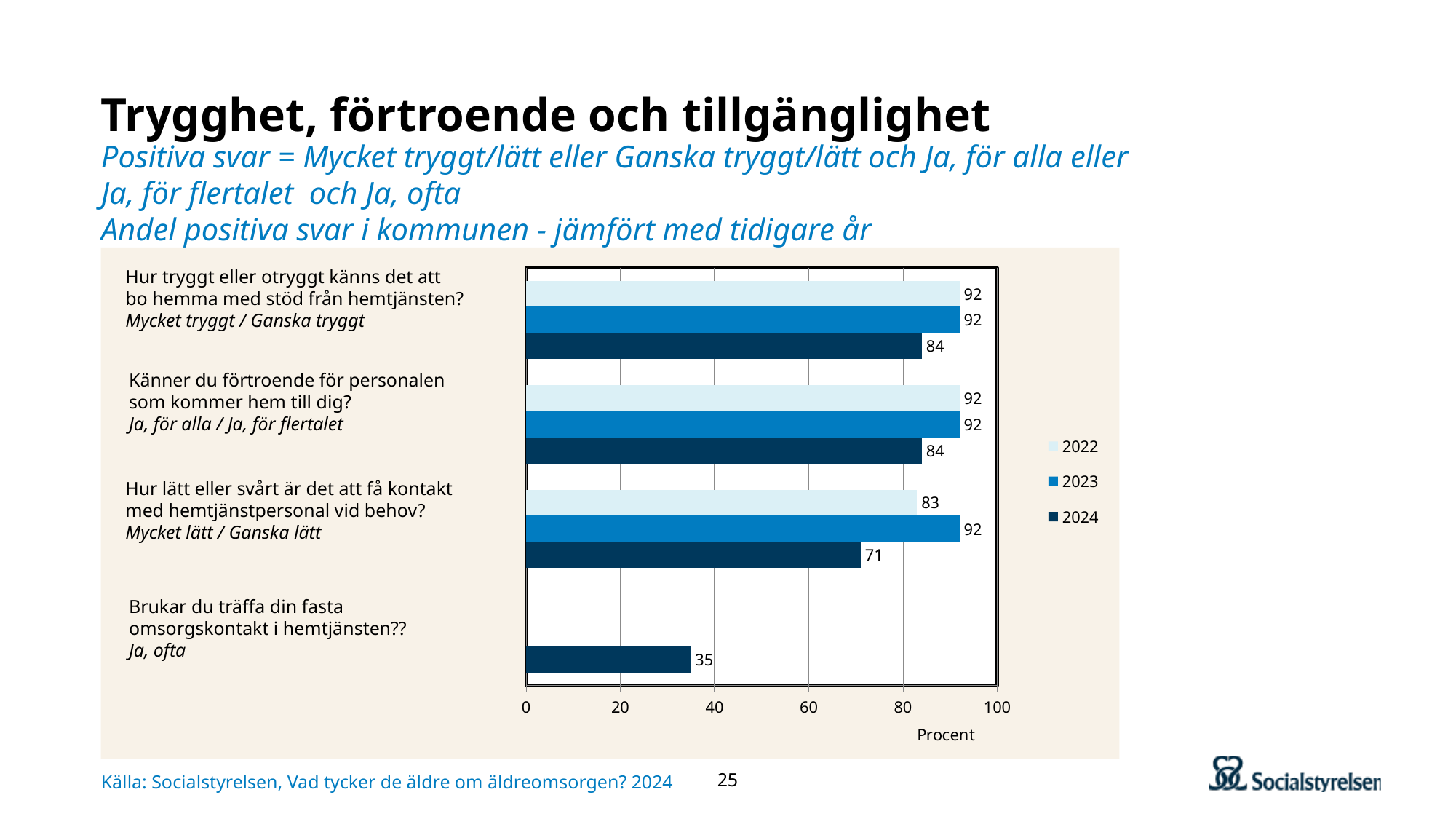
What is the difference between the 2023 and 2024 values for 'Hur lätt eller svårt är det att få kontakt med hemtjänstpersonal vid behov?'? 21 What is the 2024 value for 'Hur tryggt eller otryggt känns det att bo hemma med stöd från hemtjänsten?'? 84 How many series does the legend list? 3 Is the 2024 value for 'Känner du förtroende för personalen som kommer hem till dig?' larger or smaller than the 2023 value? smaller Which question has the lowest 2024 value? Brukar du träffa din fasta omsorgskontakt i hemtjänsten? Which years are listed in the legend? 2022, 2023, 2024 Is the 2024 value for 'Brukar du träffa din fasta omsorgskontakt i hemtjänsten?' greater or less than 40? less What is the 2023 value for 'Hur lätt eller svårt är det att få kontakt med hemtjänstpersonal vid behov?'? 92 What is the 2022 value for 'Hur lätt eller svårt är det att få kontakt med hemtjänstpersonal vid behov?'? 83 What is the 2024 value for 'Brukar du träffa din fasta omsorgskontakt i hemtjänsten?'? 35 What kind of chart is shown on the slide? bar chart What is the label on the horizontal axis? Procent